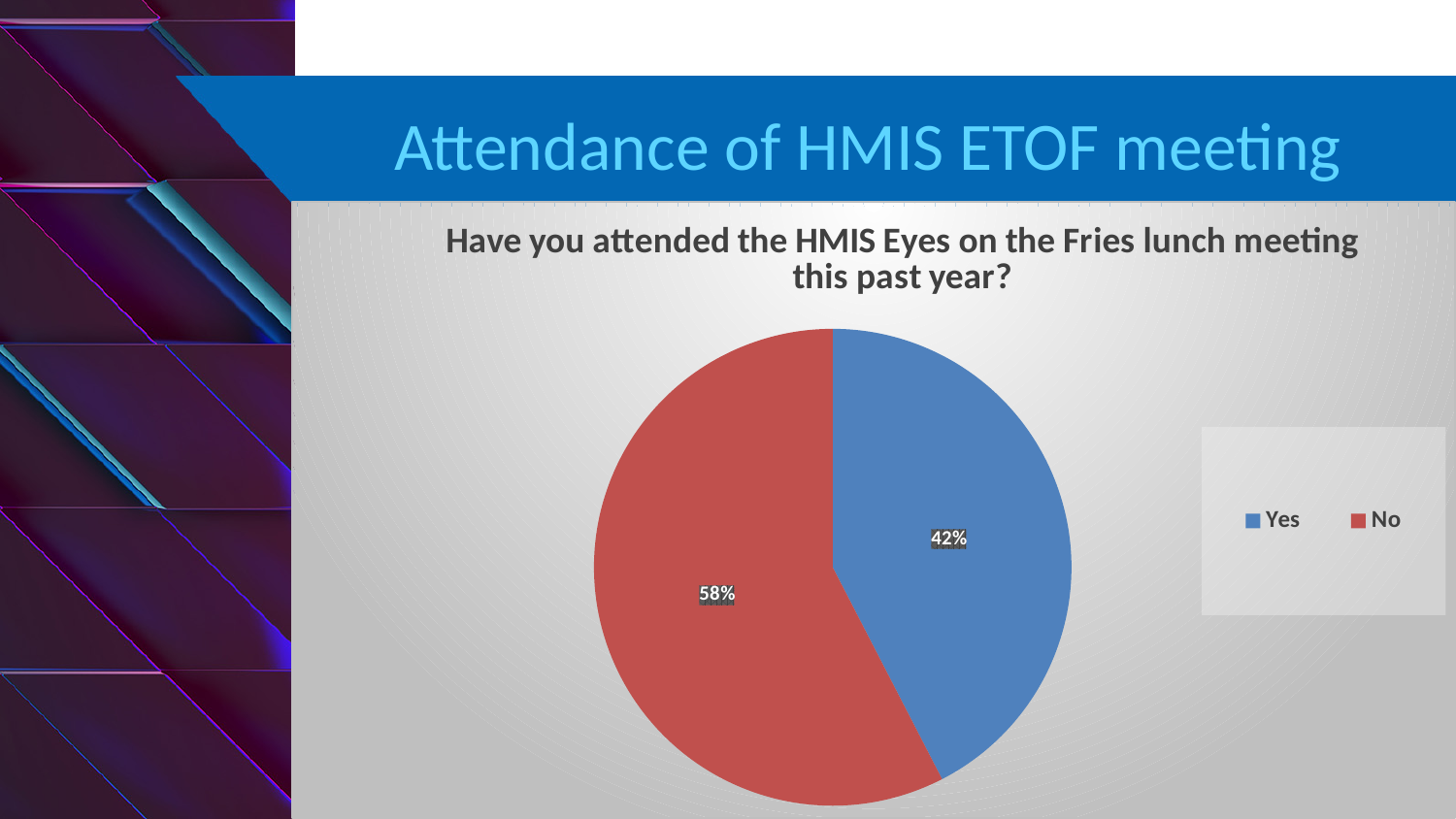
What percentage of respondents answered Yes? 42% What colour is the Yes slice? blue What is the difference in percentage points between the No and Yes slices? 16 Which response has the larger share of the pie? No What is the title of the chart? Have you attended the HMIS Eyes on the Fries lunch meeting this past year? What share of the pie does the No slice represent? 58% Which response has the smaller share of the pie? Yes How many entries does the legend list? 2 How many slices does the pie chart have? 2 What kind of chart is shown on the slide? pie chart What percentage of respondents answered No? 58% Is the share for Yes larger or smaller than the share for No? smaller